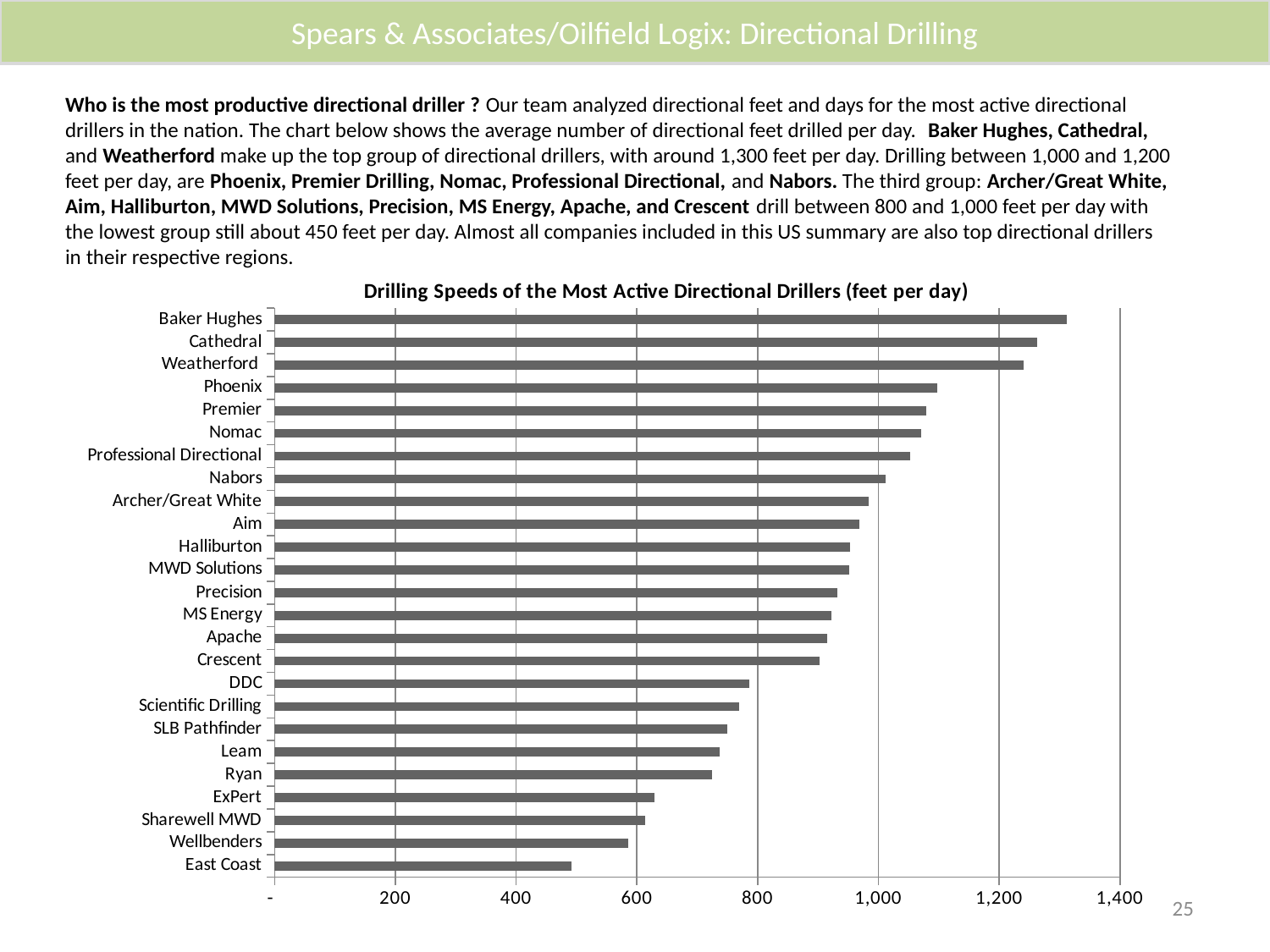
Is the value for Phoenix greater or less than 1,000? greater Which has a higher drilling speed, Phoenix or Ryan? Phoenix Is the value for Ryan greater or less than 800? less Which driller has the lowest drilling speed in the chart? East Coast Is the value for Crescent greater or less than 800? greater Which driller has the highest drilling speed in the chart? Baker Hughes How many drillers are plotted in the chart? 25 What is the title of the chart? Drilling Speeds of the Most Active Directional Drillers (feet per day) Do the bar values increase or decrease going from the top of the chart to the bottom? decrease What kind of chart is shown on the slide? bar chart